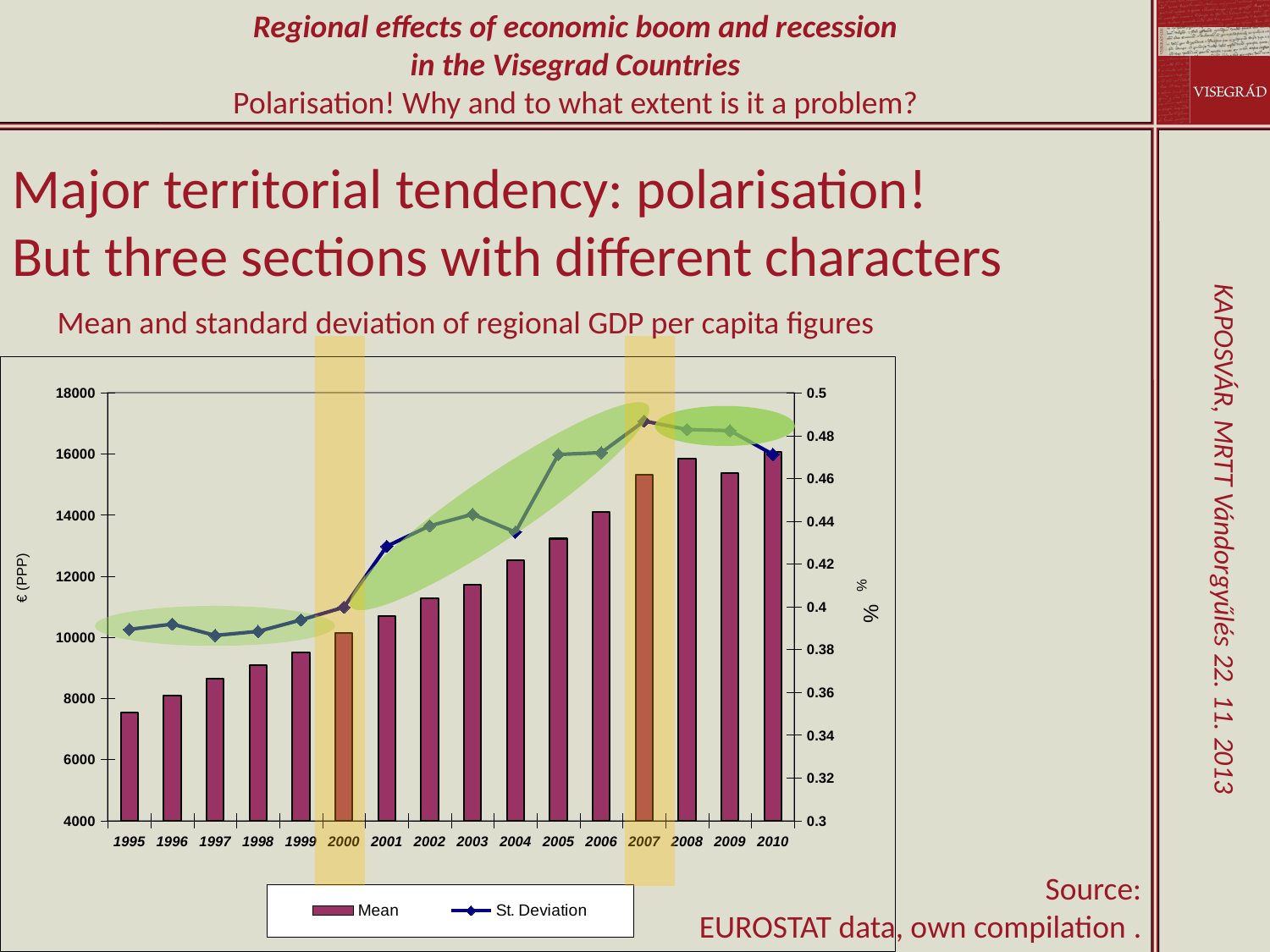
Does the Mean generally rise or fall from 1995 to 2010? rise Is the St. Deviation value for 2005 greater or less than 0.46? greater How many series does the chart legend list? 2 Is the Mean value for 1995 greater or less than 8000? less What kind of chart is shown on the slide? A combined bar and line chart In which year does the St. Deviation line reach its highest point? 2007 Is the St. Deviation value for 1995 greater or less than 0.4? less Which year has the larger Mean bar, 2008 or 2009? 2008 How many years are shown on the x axis of the chart? 16 Which year has the lowest Mean bar? 1995 Which year has the higher St. Deviation value, 2003 or 2004? 2003